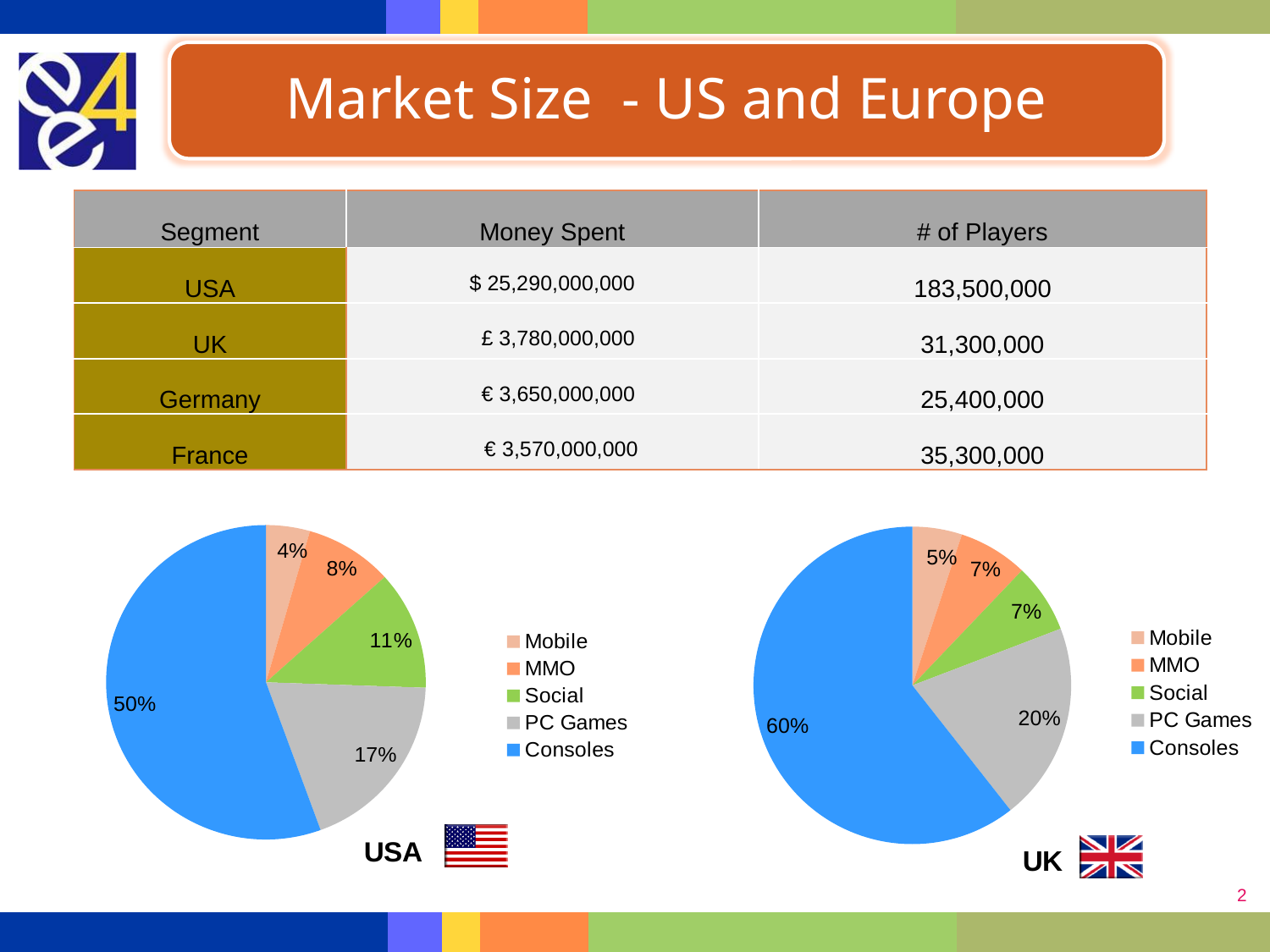
In the UK pie chart, what share does Mobile have? 5% In the USA pie chart, what share do Consoles have? 50% In the USA pie chart, what is the difference between the PC Games share and the MMO share? 9% In the UK pie chart, which is larger, the share for PC Games or the share for MMO? PC Games What kind of chart is the UK chart? Pie chart How many entries does the legend of the UK pie chart list? 5 In the USA pie chart, what share does Social have? 11% In the USA pie chart, which segment has the largest share? Consoles How many segments does the USA pie chart show? 5 In the UK pie chart, what share do PC Games have? 20% In the UK pie chart, which segment has the smallest share? Mobile In the USA pie chart, which segment has the smallest share? Mobile